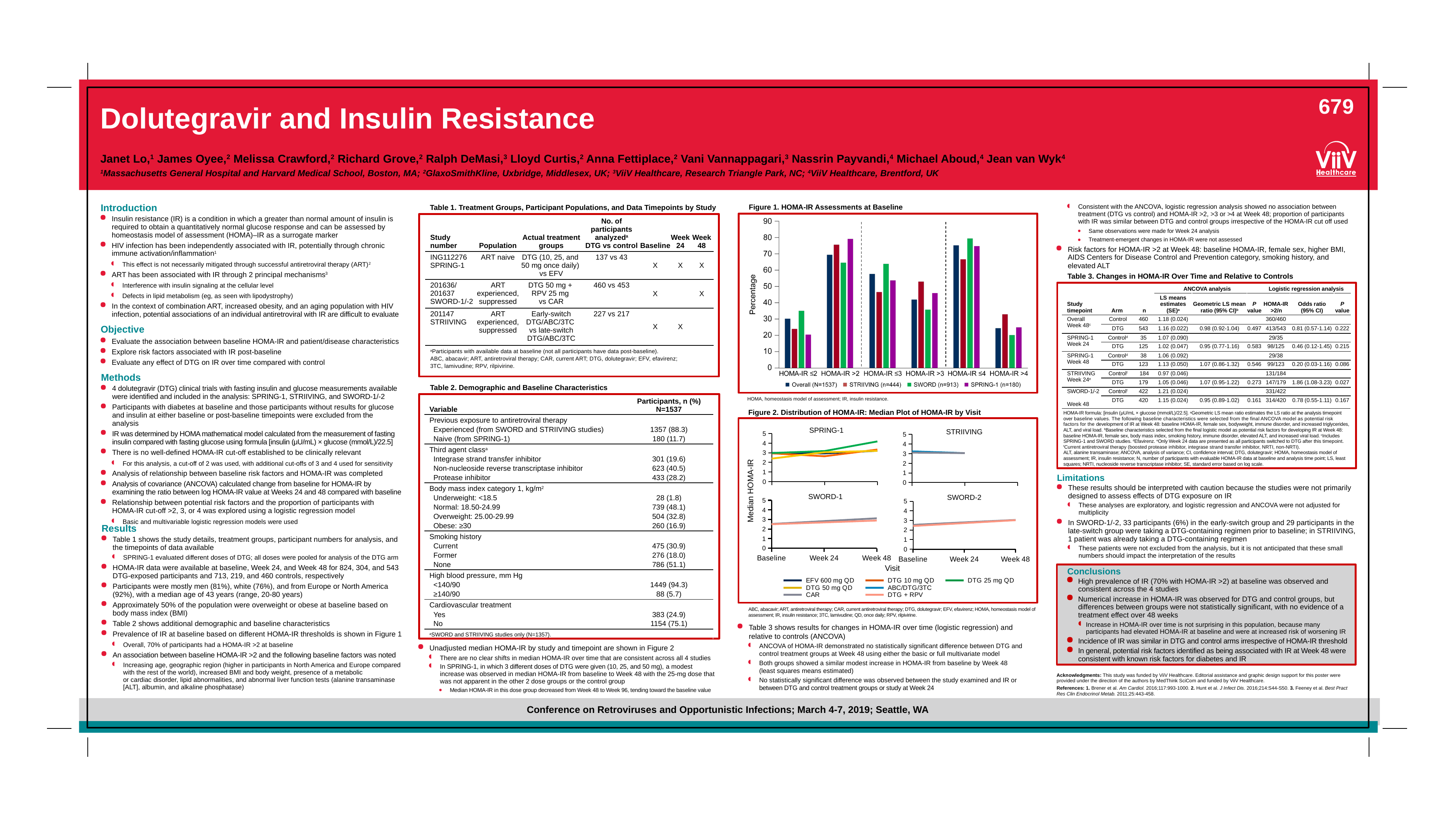
In Figure 1 (HOMA-IR Assessments at Baseline), which series has the lowest value at HOMA-IR >3? SWORD (n=913) In Figure 1 (HOMA-IR Assessments at Baseline), how many series does the legend list? 4 In Figure 1 (HOMA-IR Assessments at Baseline), how many HOMA-IR categories are shown on the x axis? 6 In Figure 1 (HOMA-IR Assessments at Baseline), what kind of chart is shown? bar chart In Figure 1 (HOMA-IR Assessments at Baseline), which series has the highest value at HOMA-IR >4? STRIIVING (n=444) In Figure 2 (Distribution of HOMA-IR: Median Plot of HOMA-IR by Visit), does the DTG 25 mg QD line in the SPRING-1 panel rise or fall from Baseline to Week 48? rise In Figure 2 (Distribution of HOMA-IR: Median Plot of HOMA-IR by Visit), how many treatment groups does the legend list? 7 In Figure 1 (HOMA-IR Assessments at Baseline), is the value for STRIIVING (n=444) at HOMA-IR ≤2 greater or less than 30? less In Figure 1 (HOMA-IR Assessments at Baseline), at HOMA-IR ≤2, which is larger: SWORD (n=913) or SPRING-1 (n=180)? SWORD (n=913) In Figure 1 (HOMA-IR Assessments at Baseline), is the value for SWORD (n=913) at HOMA-IR >4 greater or less than 30? less In Figure 1 (HOMA-IR Assessments at Baseline), is the value for SPRING-1 (n=180) at HOMA-IR >2 greater or less than 70? greater In Figure 2 (Distribution of HOMA-IR: Median Plot of HOMA-IR by Visit), what kind of chart is shown? line chart